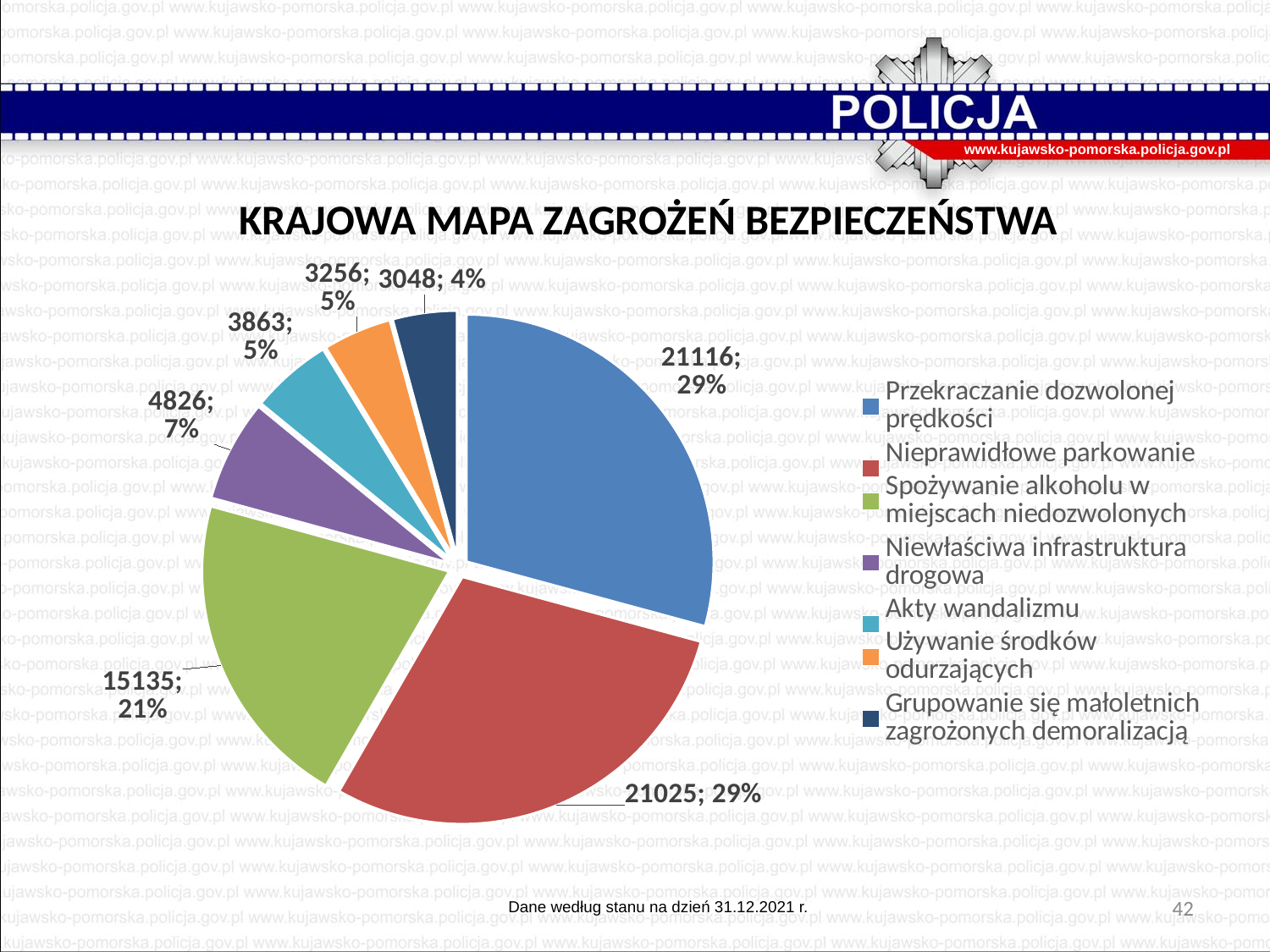
How many categories does the legend list? 7 Which is larger: the value for Akty wandalizmu or the value for Używanie środków odurzających? Akty wandalizmu What is the difference between the values for Przekraczanie dozwolonej prędkości and Nieprawidłowe parkowanie? 91 What share of the pie does Niewłaściwa infrastruktura drogowa represent? 7% What is the value for Grupowanie się małoletnich zagrożonych demoralizacją? 3048 Which category has the largest value? Przekraczanie dozwolonej prędkości What is the value for Przekraczanie dozwolonej prędkości? 21116 What is the value for Nieprawidłowe parkowanie? 21025 What is the value for Spożywanie alkoholu w miejscach niedozwolonych? 15135 What kind of chart is shown on the slide? pie chart What is the title of the chart? KRAJOWA MAPA ZAGROŻEŃ BEZPIECZEŃSTWA Which category has the smallest value? Grupowanie się małoletnich zagrożonych demoralizacją